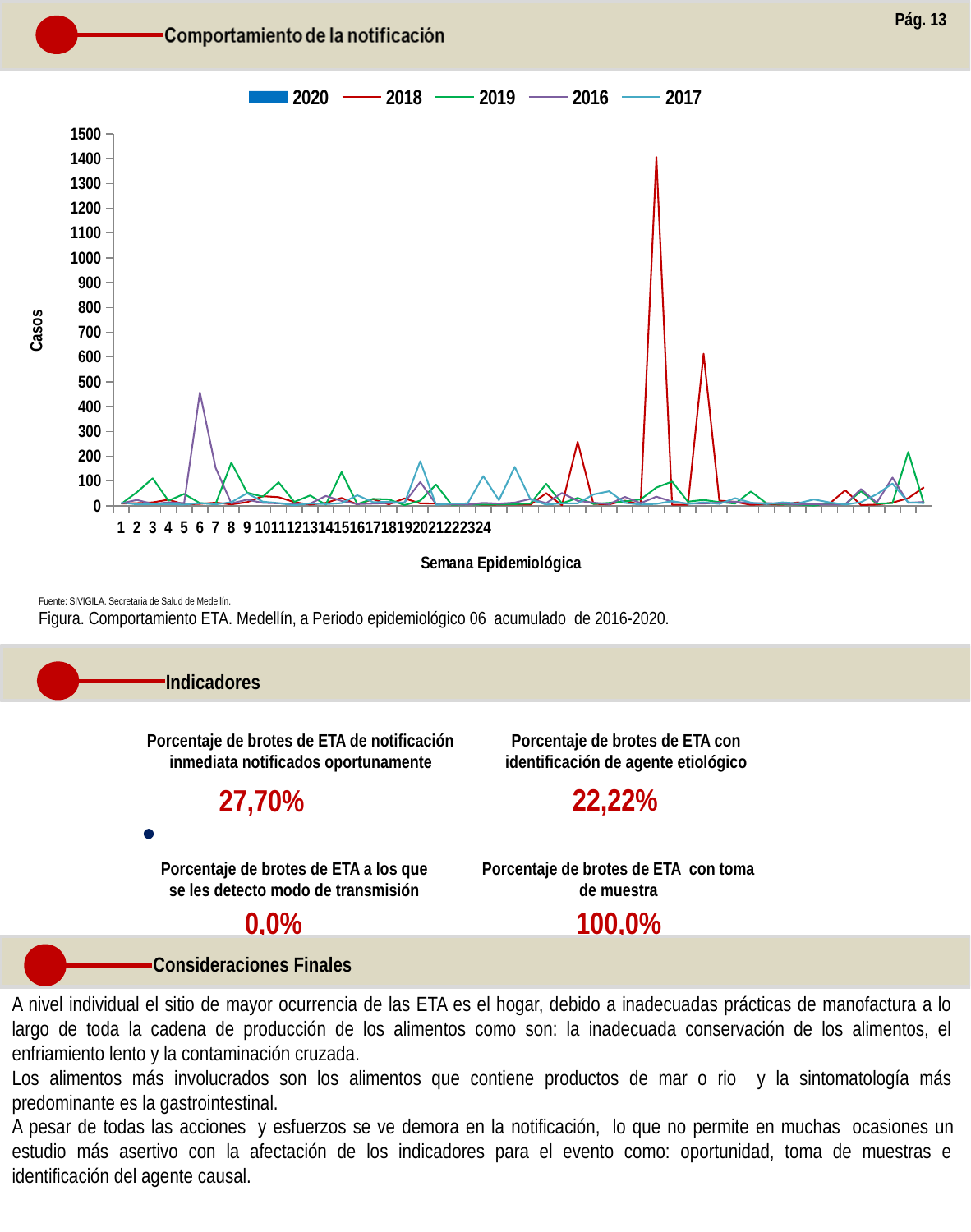
Is the value for the 2016 series at week 6 greater or less than 500? less At week 6, which series has the larger value, 2016 or 2019? 2016 Which series reaches the highest value on the chart? 2018 Is the highest value of the 2018 series greater or less than 1300? greater What is the title of the vertical axis of the chart? Casos What is the title of the horizontal axis of the chart? Semana Epidemiológica Is the value for the 2019 series at week 8 greater or less than 100? greater How many series does the chart legend list? 5 What kind of chart is shown on the slide? combination bar and line chart